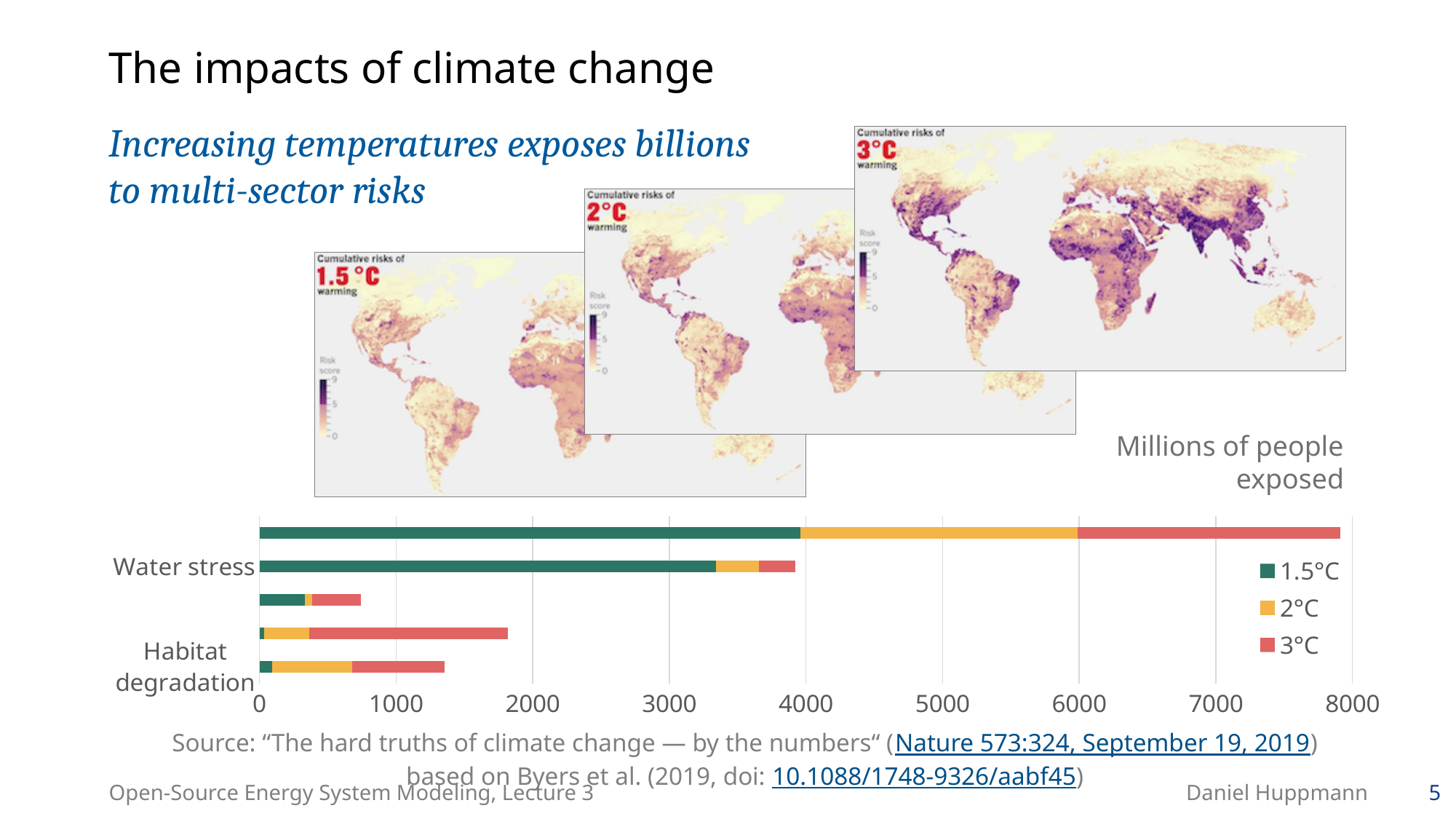
What does the bar chart measure, according to the label above the legend? Millions of people exposed Which has a longer total bar, Water stress or Habitat degradation? Water stress Is the total length of the Habitat degradation bar greater or less than 2000? less What is the highest value shown on the x axis of the bar chart? 8000 Is the 1.5°C segment of the Habitat degradation bar greater or less than 1000? less Is the 1.5°C segment of the Water stress bar greater or less than 3000? greater What kind of chart is shown at the bottom of the slide? bar chart What are the three series listed in the legend of the bar chart? 1.5°C, 2°C, 3°C How many stacked bars are plotted in the bar chart? 5 How many series does the legend of the bar chart list? 3 Which has a longer 1.5°C segment, Water stress or Habitat degradation? Water stress